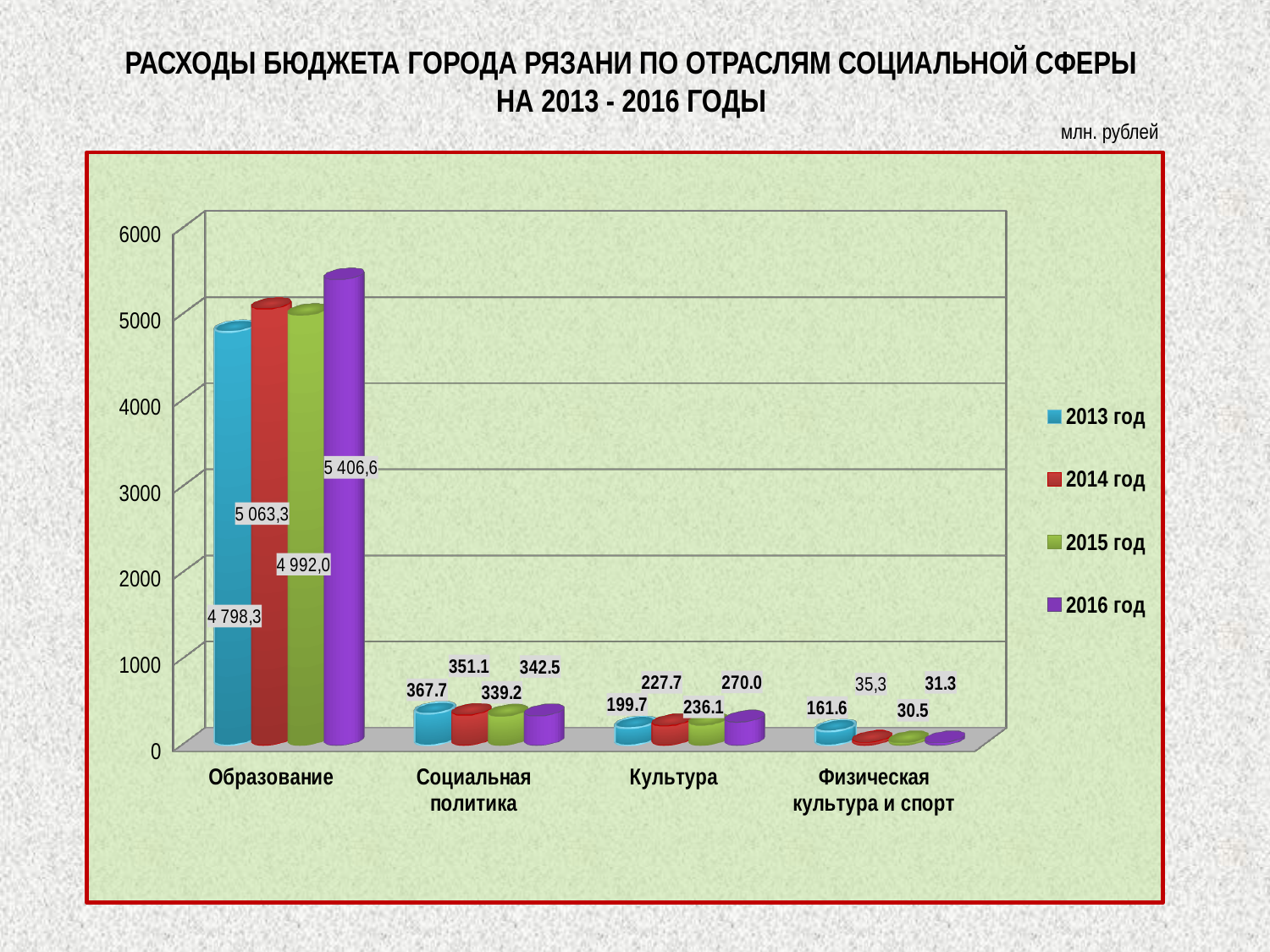
How many series does the legend list? 4 Is the value for Образование in 2013 год greater or less than 5000? less What is the value for Культура in 2015 год? 236.1 Which category has the lowest value in 2016 год? Физическая культура и спорт What is the difference between the 2014 год and 2013 год values for Культура? 28.0 What is the value for Социальная политика in 2013 год? 367.7 Which is larger for Социальная политика: the 2015 год value or the 2016 год value? 2016 год What kind of chart is shown on the slide? bar chart What is the value for Физическая культура и спорт in 2014 год? 35,3 Which category has the highest value in 2013 год? Образование How many categories are shown on the x axis? 4 What is the value for Образование in 2016 год? 5 406,6